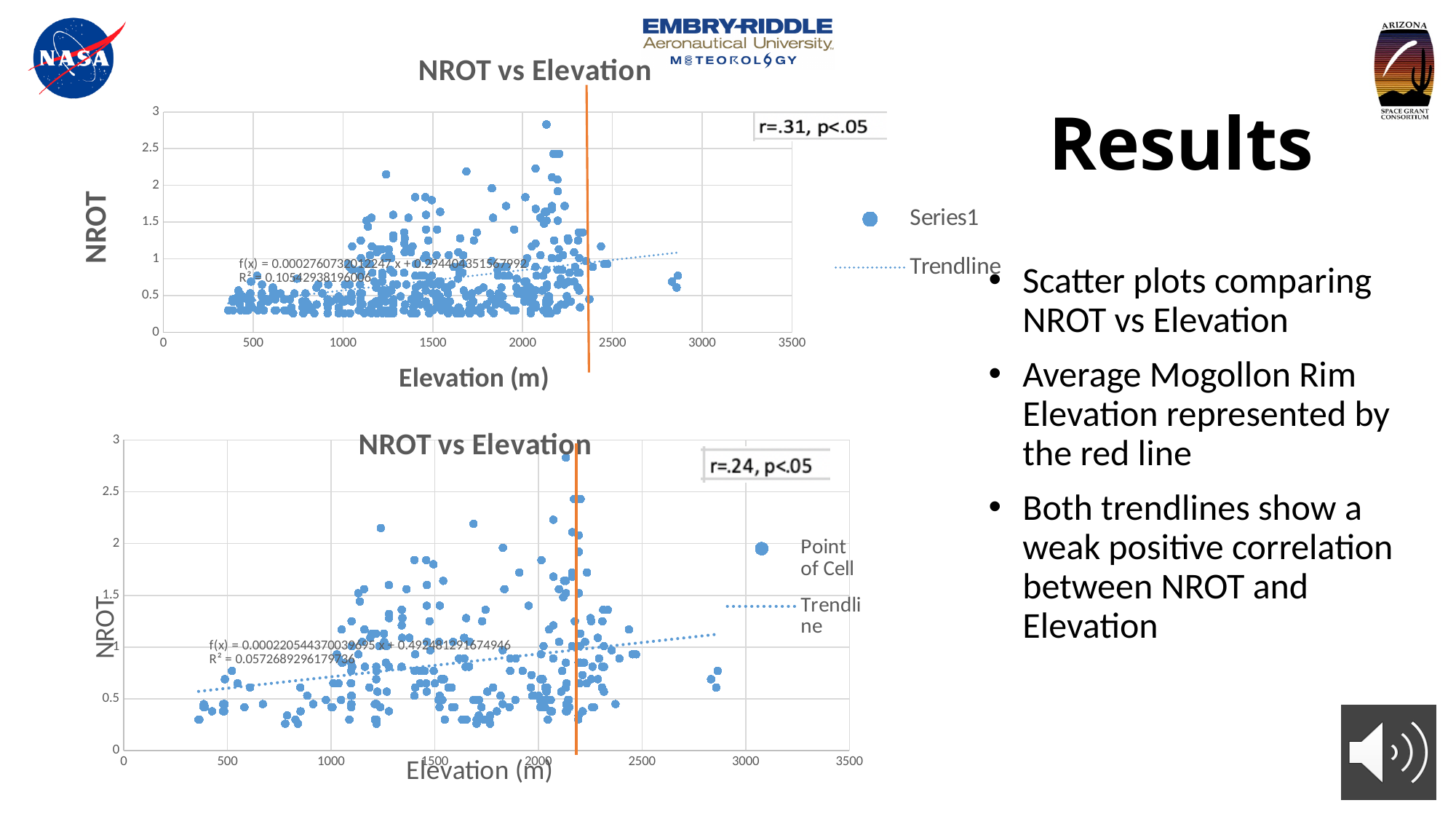
What kind of chart is the top chart on the slide? Scatter plot What is the title of the top chart? NROT vs Elevation How many entries does the legend of the bottom chart list? 2 What are the legend entries of the top chart? Series1 and Trendline What kind of chart is the bottom chart on the slide? Scatter plot In the top chart, does the trendline rise or fall as elevation increases? Rises What is the maximum value shown on the x axis of the top chart? 3500 Which chart reports the larger correlation coefficient r, the top chart or the bottom chart? The top chart What is the x-axis title of the bottom chart? Elevation (m) In the bottom chart, does the trendline rise or fall as elevation increases? Rises What correlation coefficient is shown in the text box on the top chart? r=.31, p<.05 What correlation coefficient is shown in the text box on the bottom chart? r=.24, p<.05